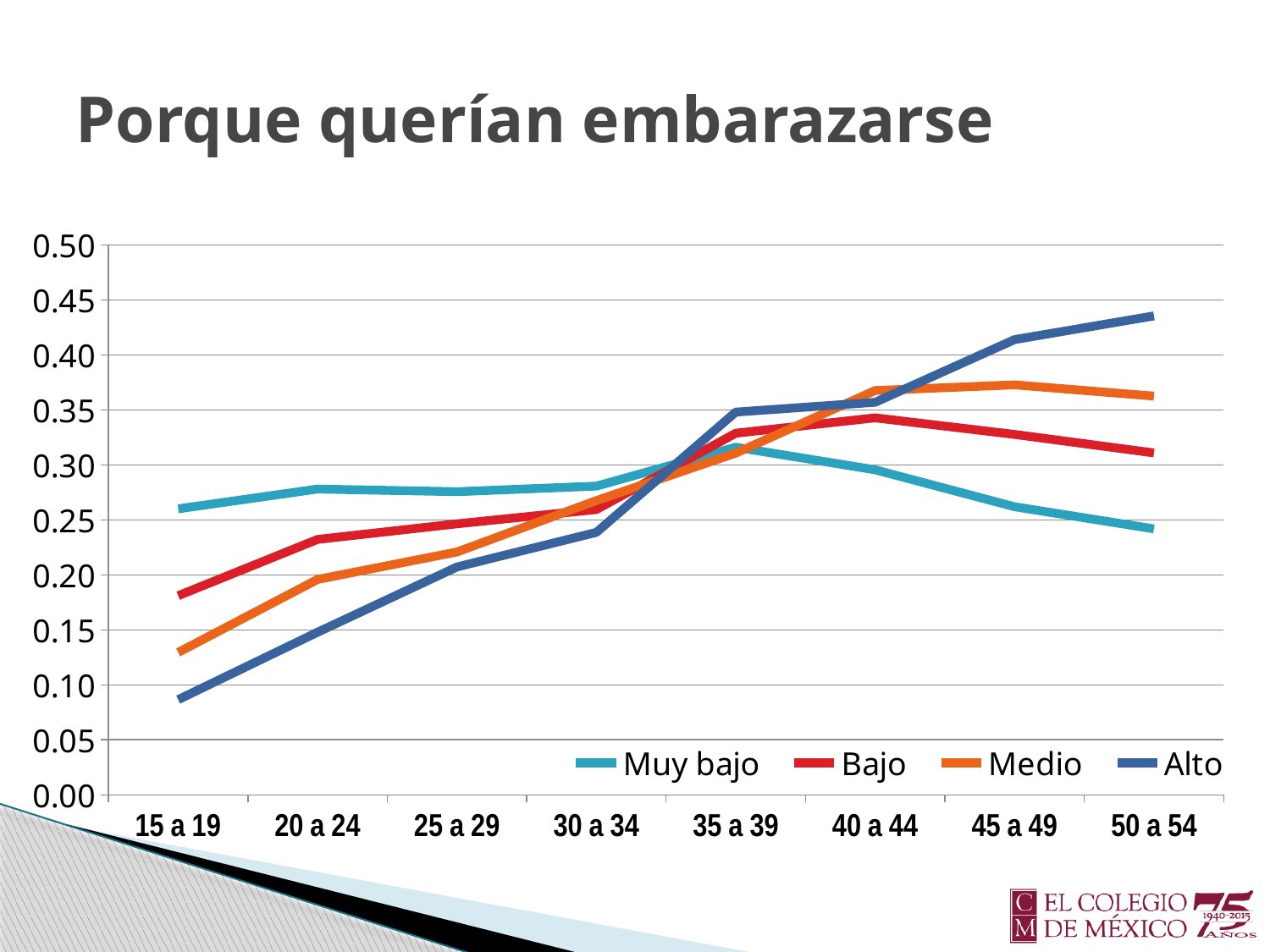
Is the value for Muy bajo at 15 a 19 greater or less than 0.20? greater Which series has the highest value at 15 a 19? Muy bajo How many age groups are shown on the x axis? 8 Which series has the lowest value at 15 a 19? Alto At 50 a 54, which is larger, Medio or Bajo? Medio What kind of chart is shown on the slide? line chart How many series does the legend list? 4 Which series has the highest value at 50 a 54? Alto Does the Alto series rise or fall from 15 a 19 to 50 a 54? rises What is the title of the slide? Porque querían embarazarse Is the value for Alto at 50 a 54 greater or less than 0.40? greater Is the value for Alto at 15 a 19 greater or less than 0.10? less